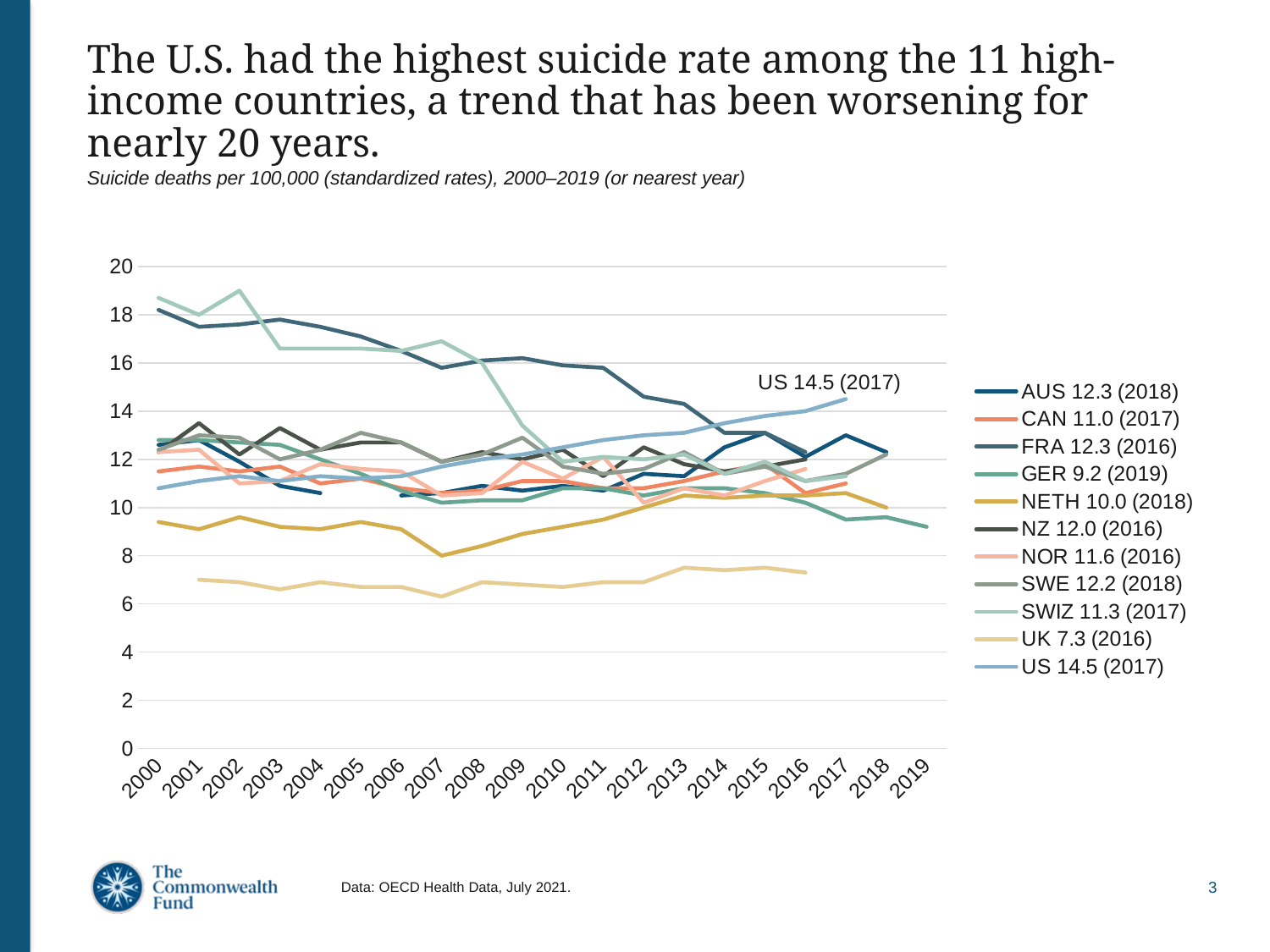
Which country has the lowest latest suicide rate shown in the legend? UK How many years are labeled on the x axis? 20 What kind of chart is shown on the slide? line chart Is the value for the UK in 2001 greater or less than 8? less According to the legend, what is the UK's suicide rate in 2016? 7.3 What is the US suicide rate value labeled on the chart for 2017? 14.5 What is the difference between the US rate of 14.5 (2017) and the UK rate of 7.3 (2016) shown in the legend? 7.2 Does the US line generally rise or fall from 2000 to 2017? rise Which country has the highest latest suicide rate shown in the legend? US Which is larger, the latest rate for CAN (2017) or the latest rate for SWIZ (2017)? SWIZ According to the legend, what is Germany's (GER) suicide rate in 2019? 9.2 How many series does the legend list? 11